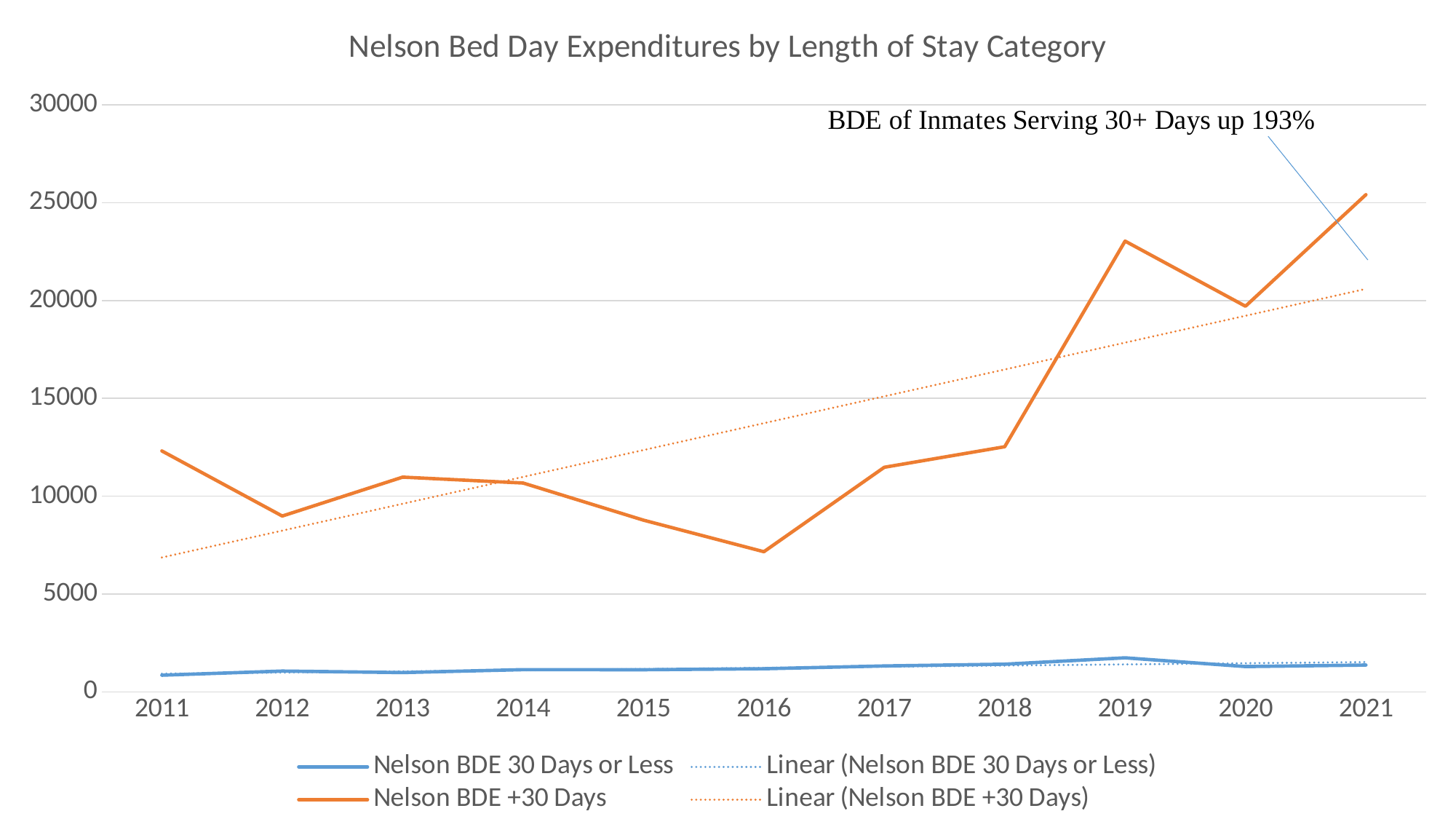
Is the value for Nelson BDE +30 Days in 2016 greater or less than 10000? less Is the value for Nelson BDE 30 Days or Less in 2019 greater or less than 5000? less What kind of chart is shown on the slide? line chart Which year has the larger value for Nelson BDE +30 Days, 2019 or 2020? 2019 In which year is the Nelson BDE +30 Days series at its highest? 2021 Is the value for Nelson BDE +30 Days in 2021 greater or less than 20000? greater In which year is the Nelson BDE +30 Days series at its lowest? 2016 What is the title of the chart? Nelson Bed Day Expenditures by Length of Stay Category How many entries does the chart's legend list? 4 Does the Linear (Nelson BDE +30 Days) trendline rise or fall from 2011 to 2021? rise How many years are shown along the x axis? 11 In 2011, which series has the larger value, Nelson BDE 30 Days or Less or Nelson BDE +30 Days? Nelson BDE +30 Days